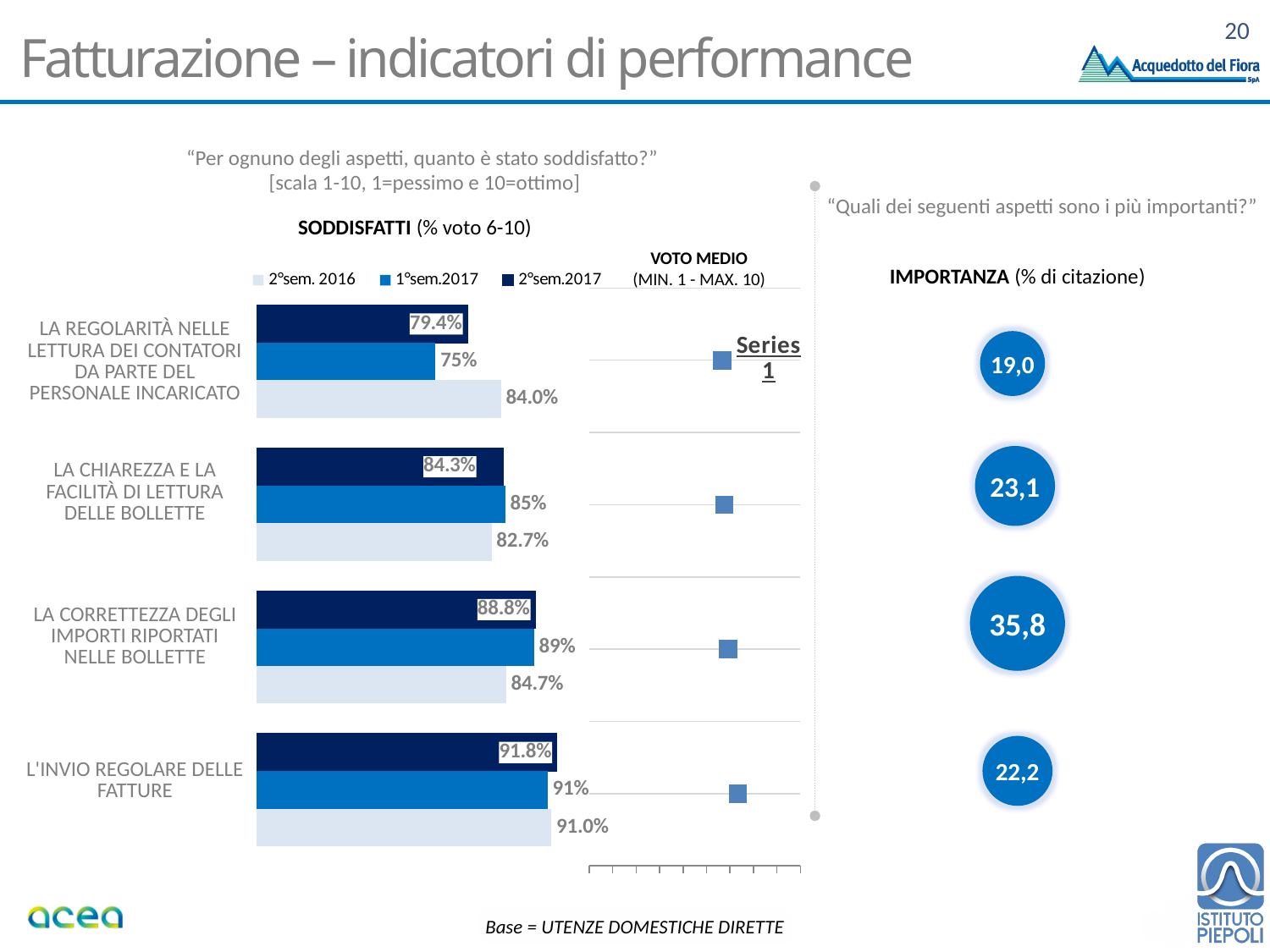
In the SODDISFATTI chart, for LA CORRETTEZZA DEGLI IMPORTI RIPORTATI NELLE BOLLETTE, which is larger: the 1°sem.2017 value or the 2°sem. 2016 value? 1°sem.2017 How many series does the legend of the SODDISFATTI chart list? 3 How many categories are shown in the SODDISFATTI chart? 4 What kind of chart is the SODDISFATTI chart? Bar chart In the SODDISFATTI chart, what is the difference between the 2°sem. 2016 and 2°sem.2017 values for LA REGOLARITÀ NELLE LETTURA DEI CONTATORI DA PARTE DEL PERSONALE INCARICATO? 4.6% In the IMPORTANZA (% di citazione) section, what is the value for LA CORRETTEZZA DEGLI IMPORTI RIPORTATI NELLE BOLLETTE? 35,8 In the SODDISFATTI chart, what is the 2°sem.2017 value for L'INVIO REGOLARE DELLE FATTURE? 91.8% In the SODDISFATTI chart, which category has the highest 2°sem.2017 value? L'INVIO REGOLARE DELLE FATTURE In the SODDISFATTI chart, what is the 1°sem.2017 value for LA REGOLARITÀ NELLE LETTURA DEI CONTATORI DA PARTE DEL PERSONALE INCARICATO? 75% In the SODDISFATTI chart, what is the 2°sem. 2016 value for LA CHIAREZZA E LA FACILITÀ DI LETTURA DELLE BOLLETTE? 82.7% In the SODDISFATTI chart, what is the 2°sem.2017 value for LA CORRETTEZZA DEGLI IMPORTI RIPORTATI NELLE BOLLETTE? 88.8% In the SODDISFATTI chart, which category has the lowest 1°sem.2017 value? LA REGOLARITÀ NELLE LETTURA DEI CONTATORI DA PARTE DEL PERSONALE INCARICATO